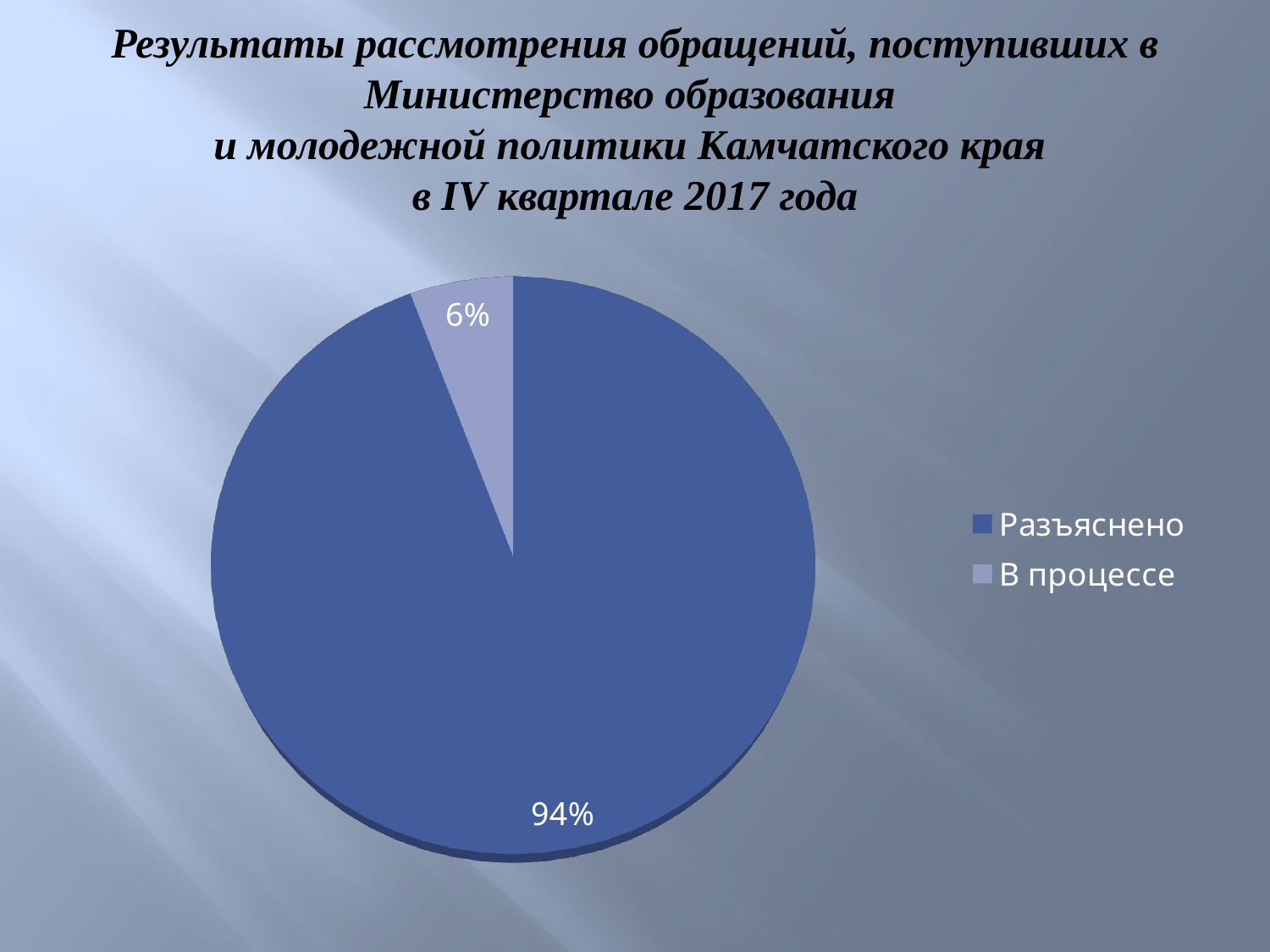
Is the share for "Разъяснено" greater or less than 50%? greater Which category has the smallest slice of the pie? В процессе How many slices does the pie chart have? 2 Which category has the largest slice of the pie? Разъяснено What share of the pie does "Разъяснено" take? 94% Which legend entry is shown in the lighter blue colour? В процессе What kind of chart is shown on the slide? pie chart Which is larger, the slice for "Разъяснено" or the slice for "В процессе"? Разъяснено How many entries does the legend list? 2 What share of the pie does "В процессе" take? 6% What is the difference in percentage points between "Разъяснено" and "В процессе"? 88